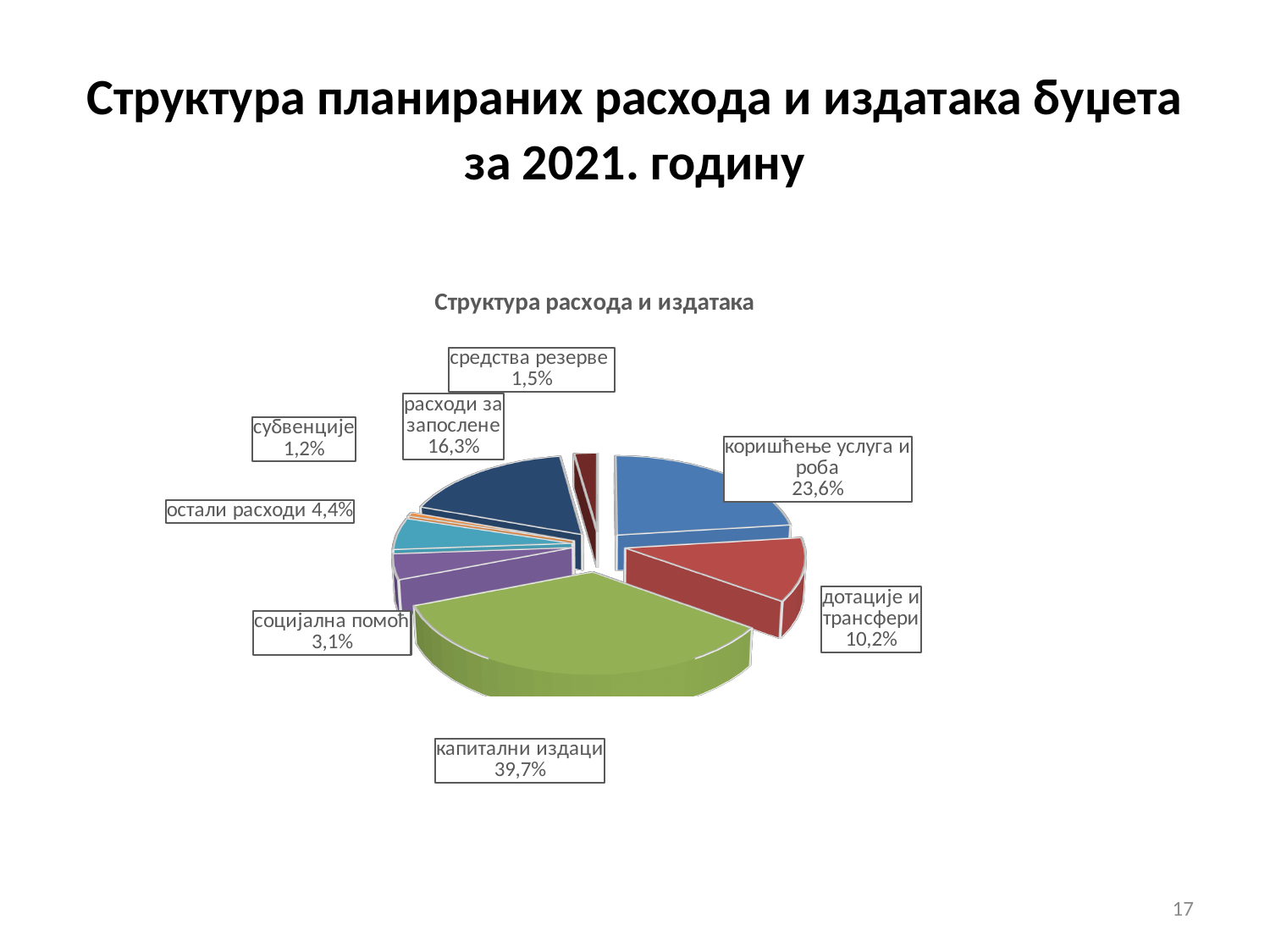
What value is labelled for средства резерве? 1,5% What percentage is shown for дотације и трансфери? 10,2% What percentage is shown for коришћење услуга и роба? 23,6% What is the title of the chart? Структура расхода и издатака Which category has the smallest share of the pie? субвенције What type of chart is shown on the slide? pie chart Which category has the largest share of the pie? капитални издаци How many slices does the pie chart have? 8 What is the difference between the shares of капитални издаци and коришћење услуга и роба? 16,1% What share of the pie is labelled for капитални издаци? 39,7% What value is shown for расходи за запослене? 16,3% Which is larger, the share for остали расходи or the share for социјална помоћ? остали расходи